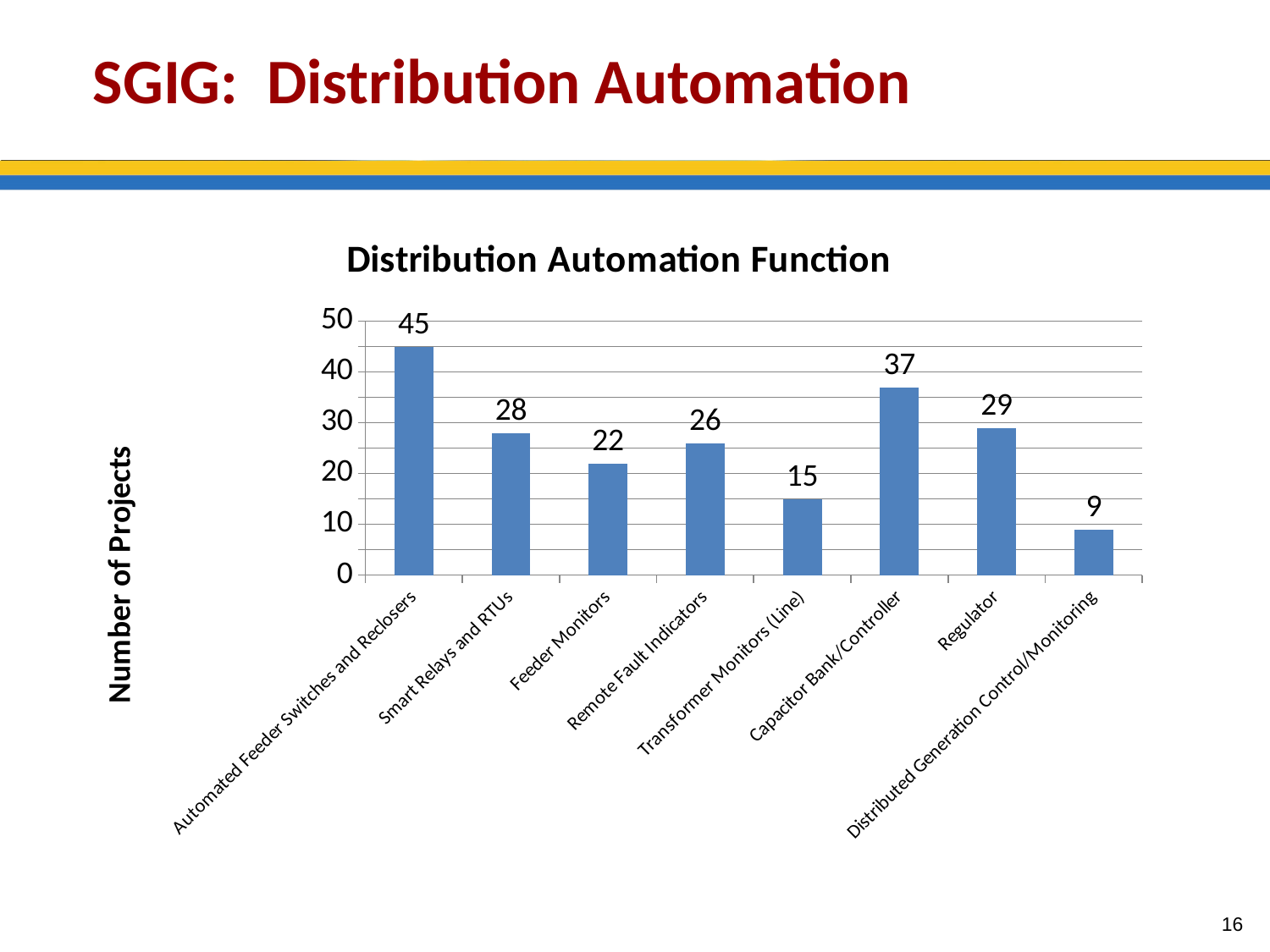
Which distribution automation function has the lowest number of projects? Distributed Generation Control/Monitoring What is the number of projects for Automated Feeder Switches and Reclosers? 45 Which has more projects, Smart Relays and RTUs or Feeder Monitors? Smart Relays and RTUs What kind of chart is shown on the slide? Bar chart What is the number of projects for Transformer Monitors (Line)? 15 Which has more projects, Remote Fault Indicators or Regulator? Regulator What is the title of the chart? Distribution Automation Function How many distribution automation functions are shown in the chart? 8 What is the difference in number of projects between Regulator and Distributed Generation Control/Monitoring? 20 What is the number of projects for Capacitor Bank/Controller? 37 What is the difference in number of projects between Automated Feeder Switches and Reclosers and Capacitor Bank/Controller? 8 Which distribution automation function has the highest number of projects? Automated Feeder Switches and Reclosers